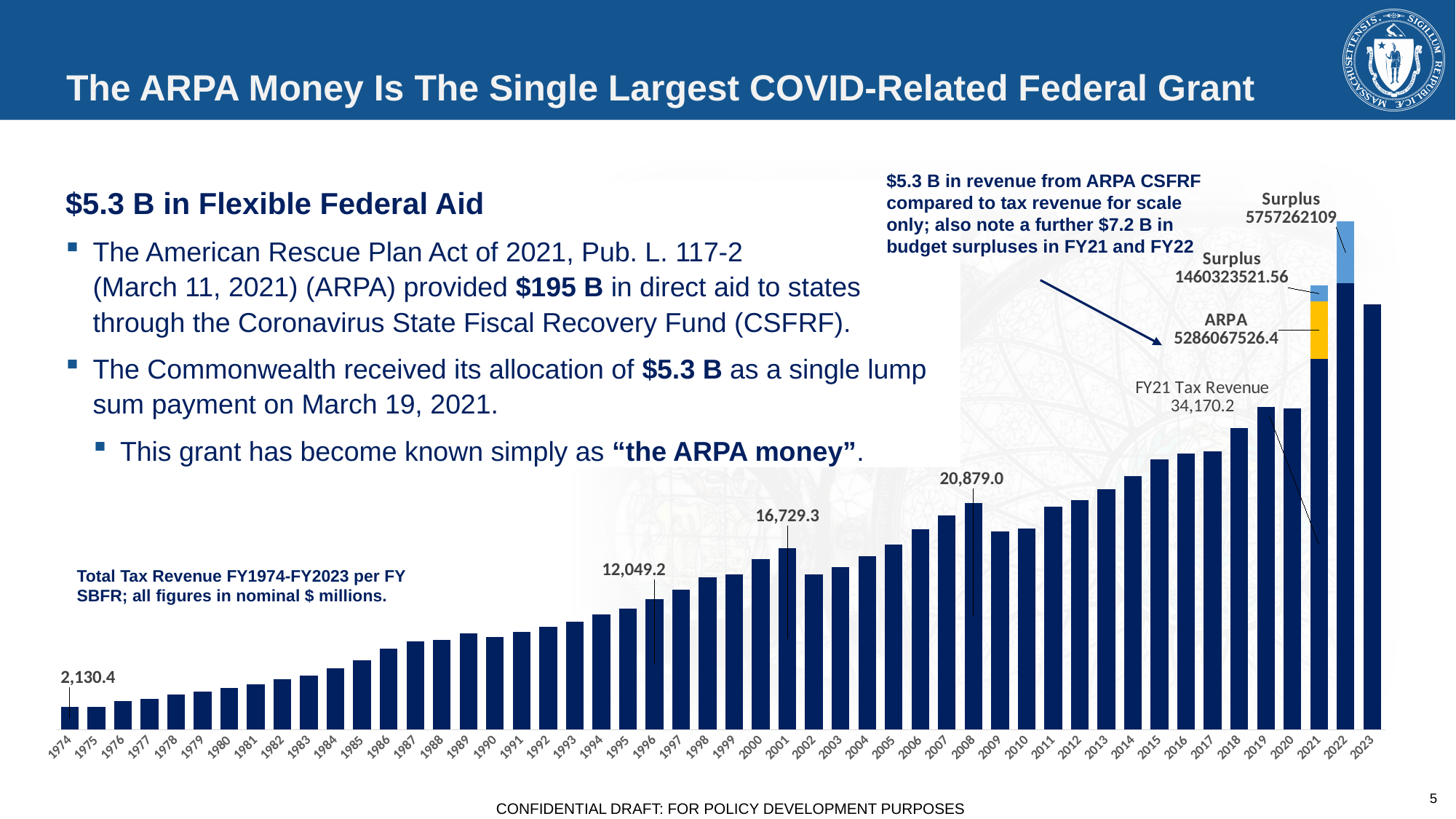
What kind of chart is shown on the slide? Bar chart Do the tax revenue values generally rise or fall from 1974 to 2023? Rise How many fiscal years are shown on the x axis of the chart? 50 What is the ARPA value labeled on the 2021 bar? 5286067526.4 What is the total tax revenue value labeled for 2001? 16,729.3 Which year has the larger labeled value, 2001 or 2008? 2008 What is the difference between the labeled values for 1996 and 1974? 9,918.8 What is the total tax revenue value labeled for 2008? 20,879.0 What is the total tax revenue value labeled for 1996? 12,049.2 What is the total tax revenue value labeled for 1974? 2,130.4 What is the difference between the labeled values for 2008 and 2001? 4,149.7 What is the FY21 Tax Revenue value labeled on the chart? 34,170.2